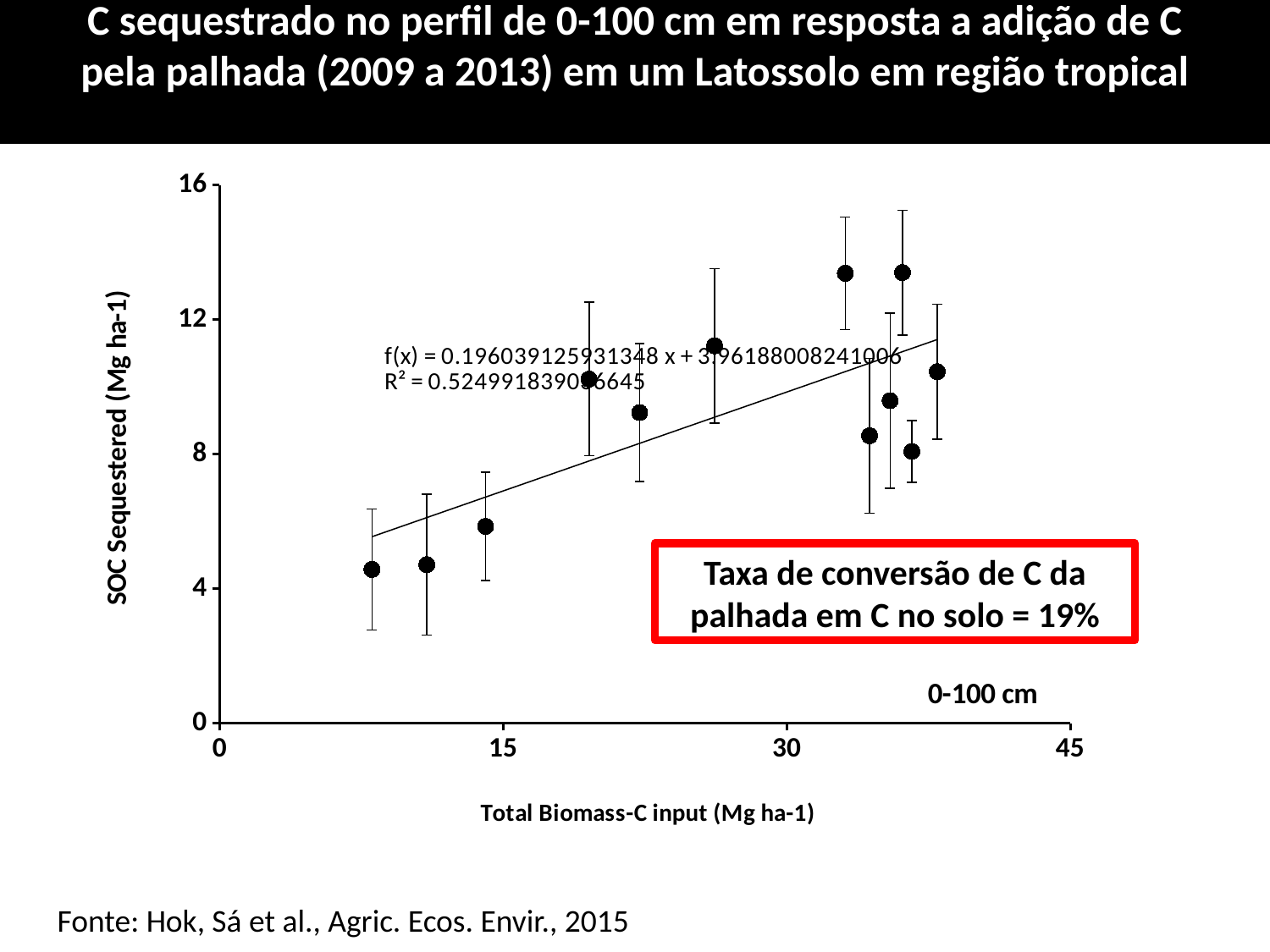
What conversion rate of straw C to soil C is stated in the red box on the chart? 19% Which has the higher SOC Sequestered value: the point at about 8 Mg ha-1 or the point at about 33 Mg ha-1 of Total Biomass-C input? the point at about 33 Mg ha-1 Is the SOC Sequestered value for the point at about 26 Mg ha-1 of Total Biomass-C input greater or less than 8? greater Is the highest SOC Sequestered value plotted on the chart greater or less than 12? greater Are all plotted points below 16 on the SOC Sequestered axis? yes What kind of chart is shown on the slide? scatter plot Do the SOC Sequestered values generally rise or fall as Total Biomass-C input increases along the x axis? rise What R² value is printed on the chart for the fitted line? 0.524991839096645